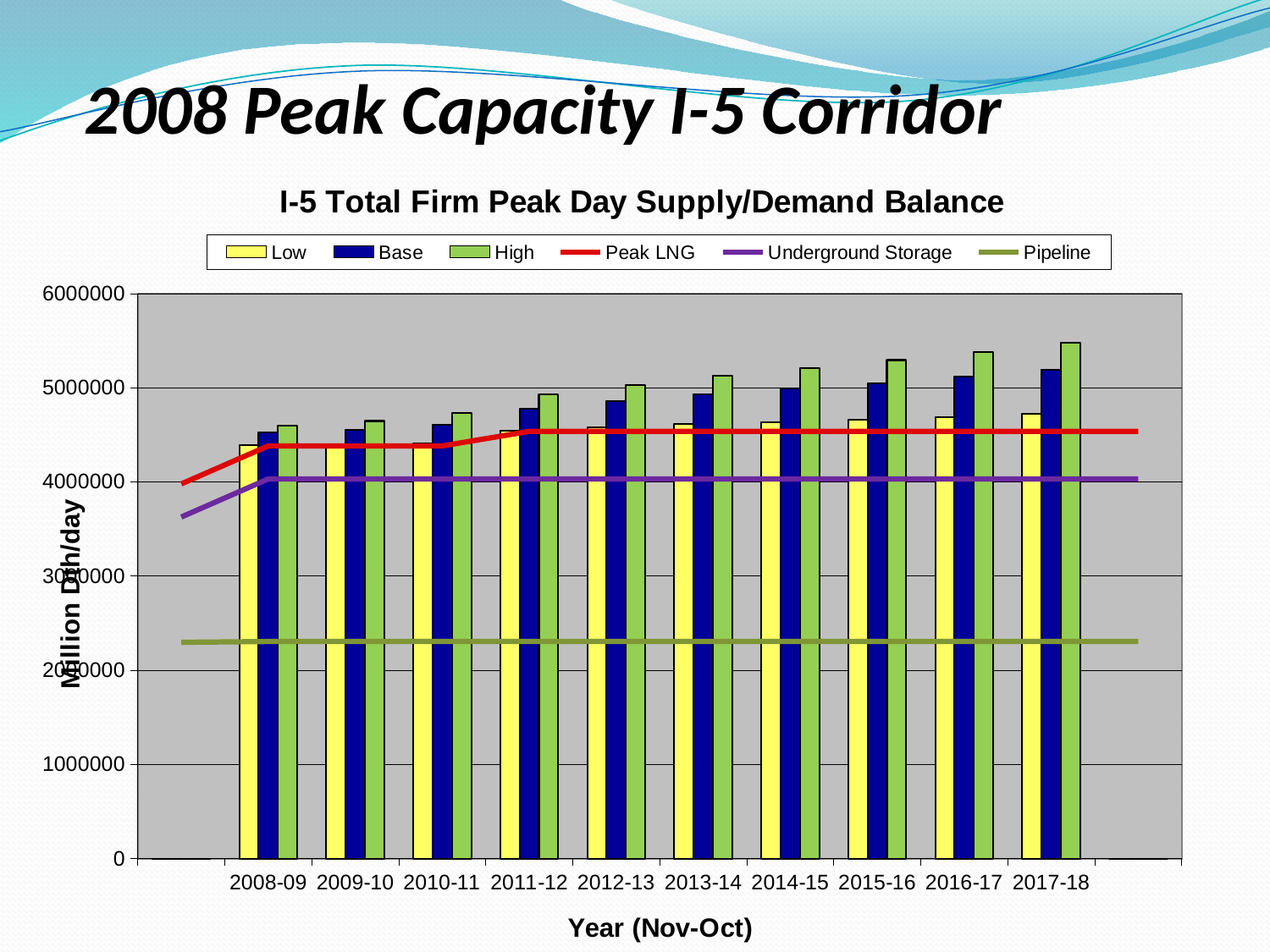
Which year has the tallest Base bar? 2017-18 Is the Peak LNG line in 2017-18 greater or less than 4000000? greater Which year has the tallest High bar? 2017-18 How many year categories are shown on the x axis? 10 Is the Low value for 2008-09 greater or less than 5000000? less What is the label of the x axis? Year (Nov-Oct) In 2017-18, which is larger, the High bar or the Low bar? High Is the High value for 2017-18 greater or less than 5000000? greater How many series does the chart legend list? 6 Do the High bars rise or fall from 2008-09 to 2017-18? rise What is the title of the chart? I-5 Total Firm Peak Day Supply/Demand Balance